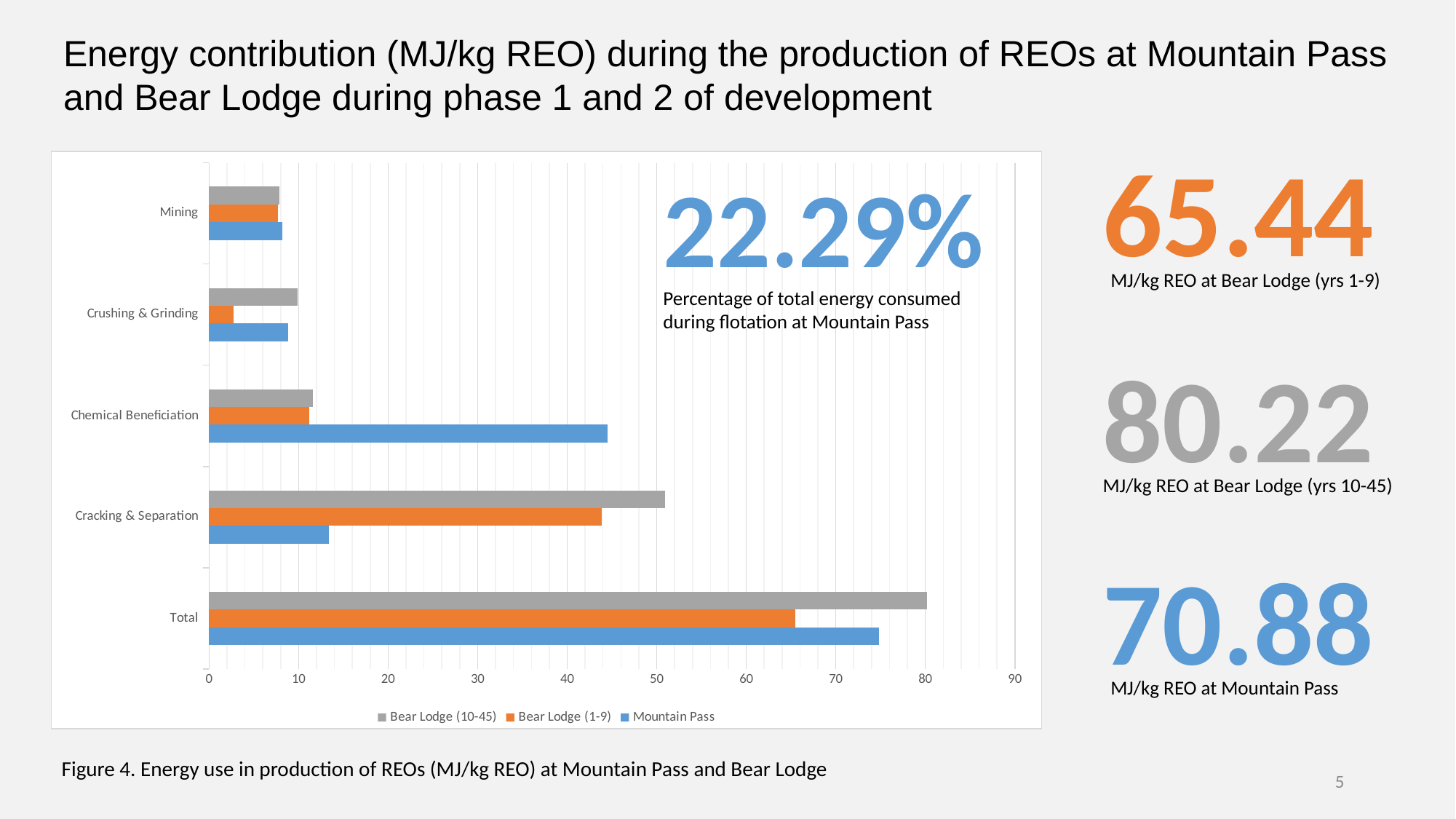
Which series has the highest value in the Chemical Beneficiation category? Mountain Pass What kind of chart is shown on the slide? bar chart How many categories are shown on the vertical axis of the chart? 5 How many series does the chart legend list? 3 Is the Mountain Pass value for Chemical Beneficiation greater or less than 40? greater Is the Bear Lodge (1-9) value for Crushing & Grinding greater or less than 10? less What is the difference between the printed Bear Lodge (yrs 10-45) total and the Bear Lodge (yrs 1-9) total? 14.78 What is the total energy use in MJ/kg REO at Bear Lodge for years 10-45, as printed on the slide? 80.22 Which series has the highest value in the Total category? Bear Lodge (10-45) In the Crushing & Grinding category, which is larger: Bear Lodge (10-45) or Bear Lodge (1-9)? Bear Lodge (10-45) Is the Bear Lodge (10-45) value for Cracking & Separation greater or less than 40? greater Which series has the lowest value in the Cracking & Separation category? Mountain Pass